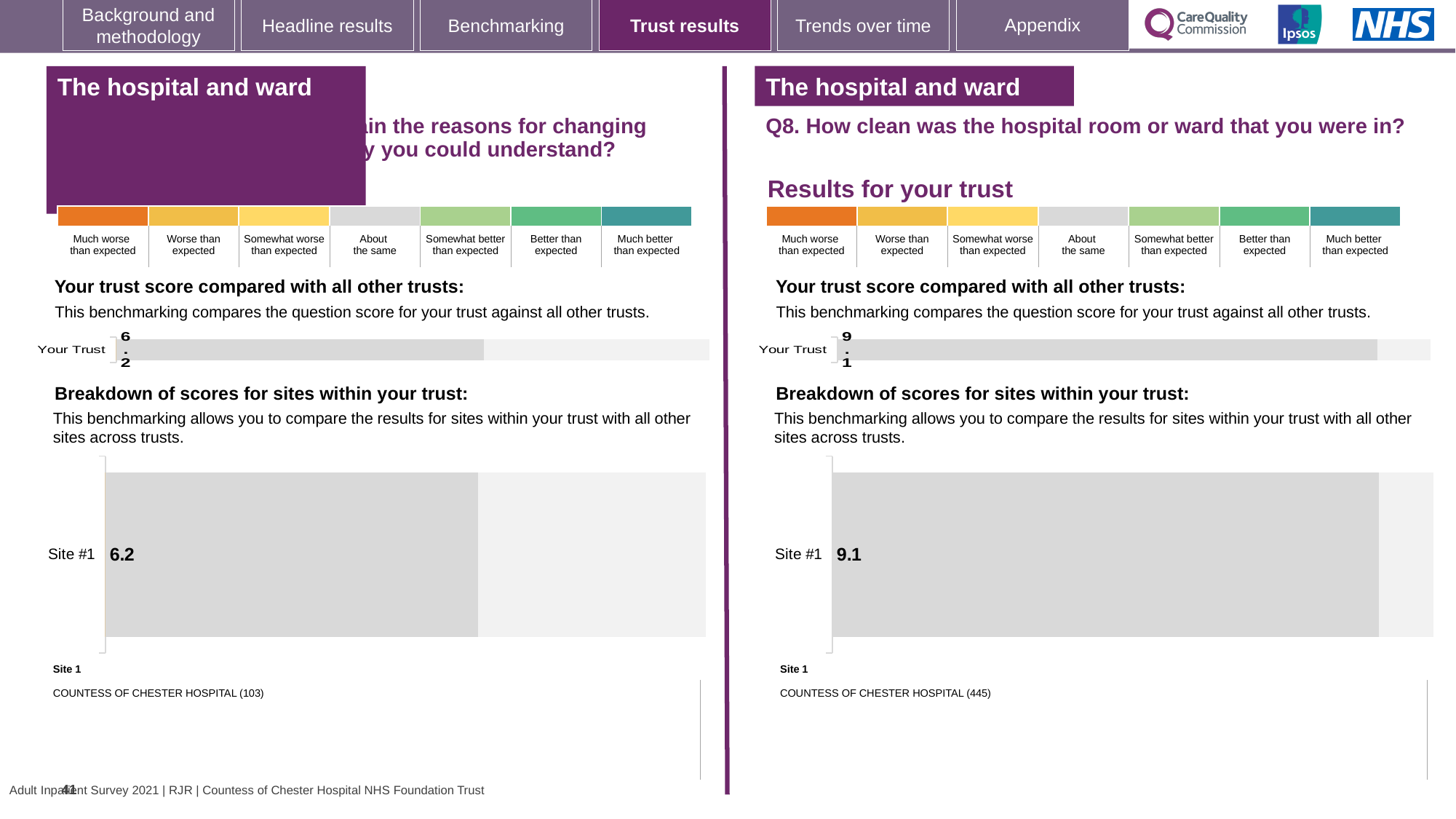
On the right half of the slide (Q8), which site is listed as Site 1 below the breakdown chart? COUNTESS OF CHESTER HOSPITAL (445) Which is larger: the Your Trust score on the left half of the slide or the Your Trust score on the right half (Q8)? The right half (Q8), 9.1 What is the difference between the Site #1 score on the right half of the slide (Q8) and the Site #1 score on the left half? 2.9 On the left half of the slide, what score is shown for Site #1 in the 'Breakdown of scores for sites within your trust' chart? 6.2 How many sites are shown in the 'Breakdown of scores for sites within your trust' chart on the right half of the slide (Q8)? 1 What kind of chart is used to show the Site #1 score in the 'Breakdown of scores for sites within your trust' section on the right half of the slide? Bar chart On the right half of the slide (Q8, how clean was the hospital room or ward), what is the score shown for Your Trust in the 'Your trust score compared with all other trusts' chart? 9.1 How many sites are shown in the 'Breakdown of scores for sites within your trust' chart on the left half of the slide? 1 On the right half of the slide (Q8), is the Your Trust score the same as the Site #1 score? Yes, both are 9.1 On the left half of the slide, what is the score shown for Your Trust in the 'Your trust score compared with all other trusts' chart? 6.2 On the right half of the slide (Q8), what score is shown for Site #1 in the 'Breakdown of scores for sites within your trust' chart? 9.1 On the left half of the slide, which site is listed as Site 1 below the breakdown chart? COUNTESS OF CHESTER HOSPITAL (103)